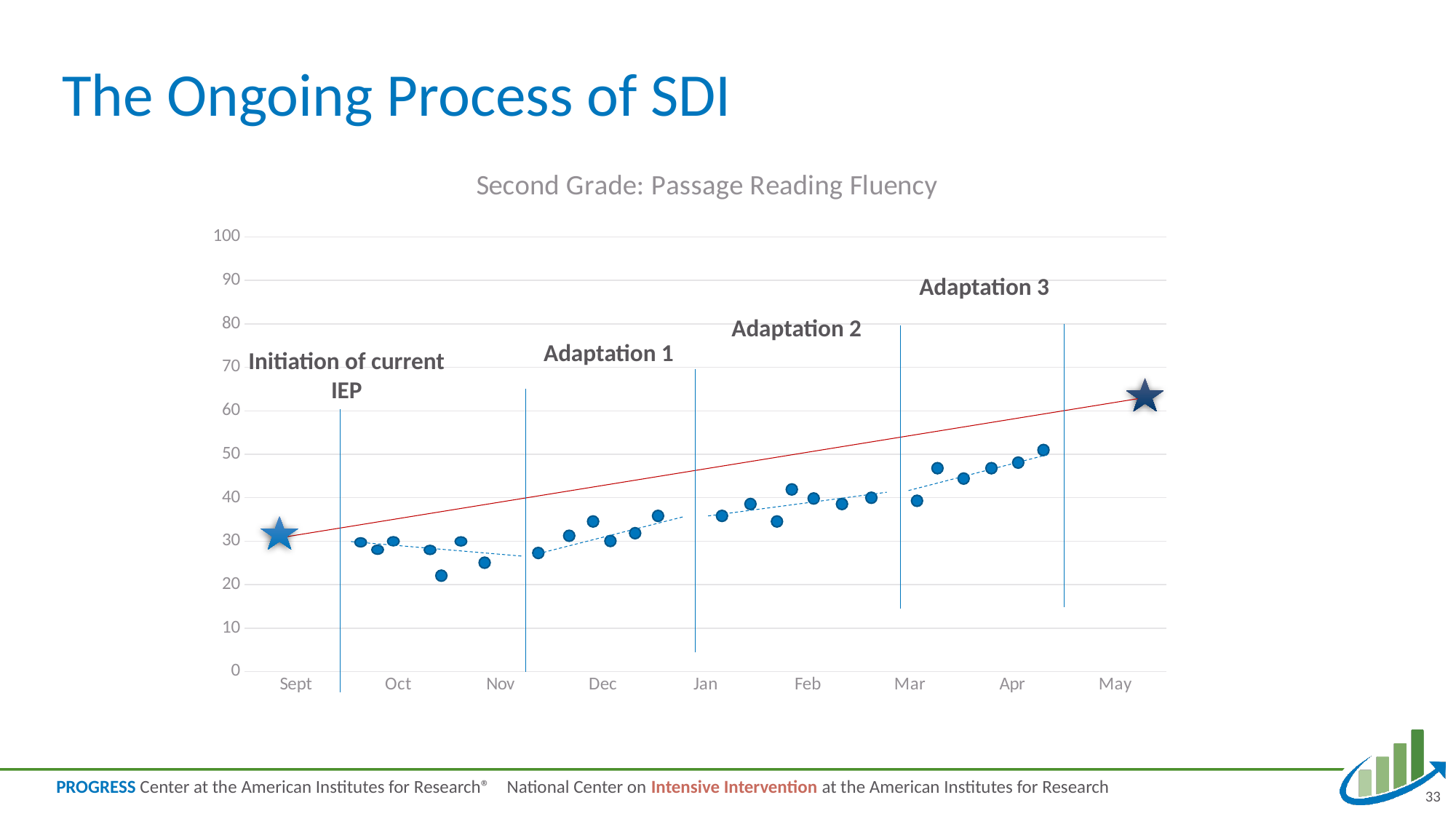
Is the highest data point in April greater or less than 40? greater How many month labels are shown on the x axis? 9 What is the label of the first vertical marker line, near September/October? Initiation of current IEP Does the red goal line rise or fall from September to May? rise Overall, do the plotted data points rise or fall from September to April? rise What kind of chart is shown on the slide? scatter chart Is the highest data point in February greater or less than 50? less Is the lowest data point in October greater or less than 30? less Which month contains the highest plotted data point? Apr How many adaptations are labelled on the chart? 3 What is the title of the chart? Second Grade: Passage Reading Fluency Which month contains the lowest plotted data point? Oct